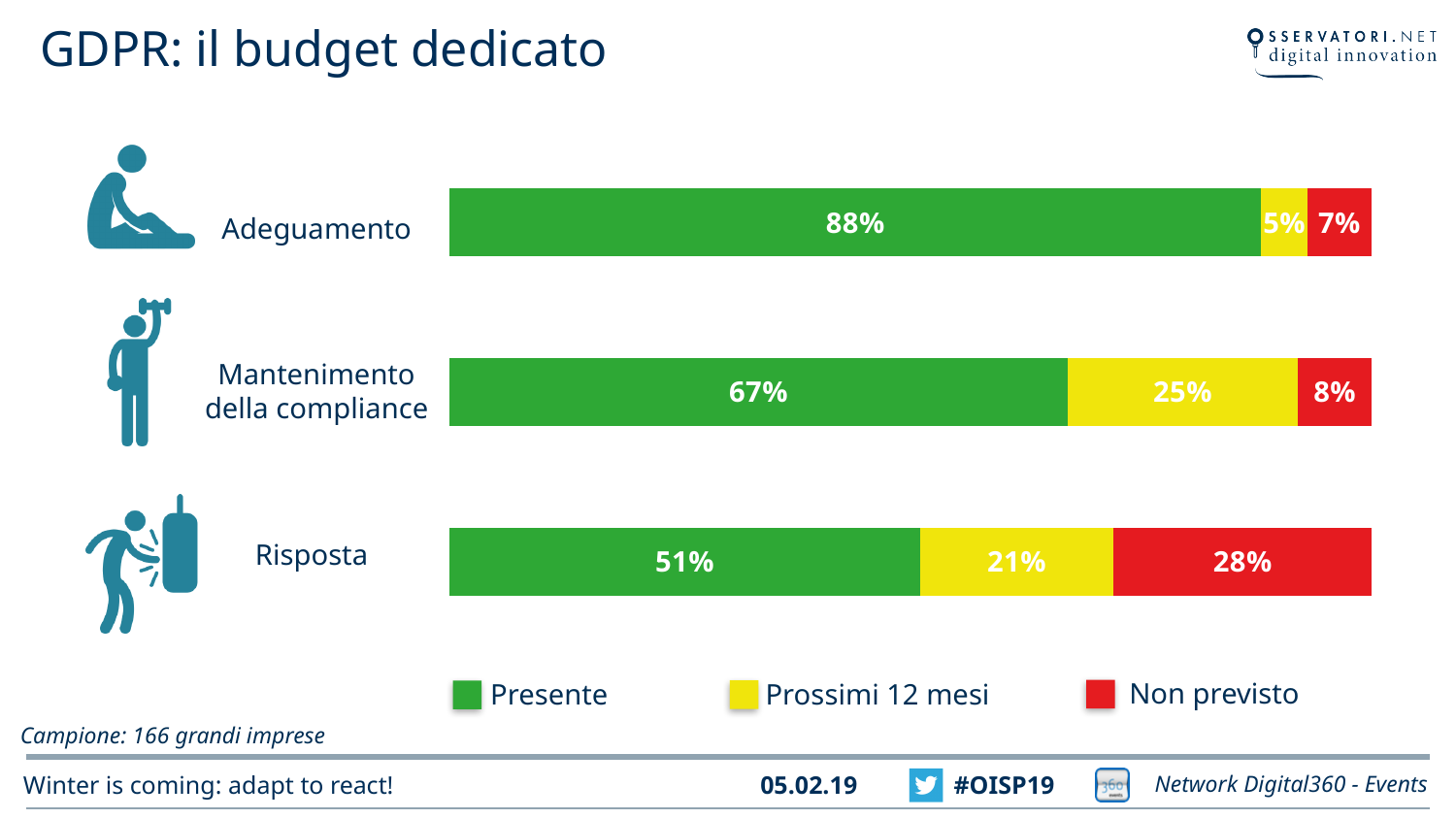
Which colour represents 'Non previsto' in the legend? Red What is the 'Prossimi 12 mesi' value for Mantenimento della compliance? 25% What kind of chart is shown on the slide? Stacked bar chart What is the difference between the 'Presente' values for Adeguamento and Risposta? 37% How many series does the legend list? 3 What is the 'Non previsto' value for Risposta? 28% Which category has the lowest 'Non previsto' value? Adeguamento What is the total of the stacked bar for Risposta? 100% Which is larger: the 'Prossimi 12 mesi' value for Mantenimento della compliance or for Risposta? Mantenimento della compliance Which category has the highest 'Presente' value? Adeguamento What is the 'Presente' value for Adeguamento? 88% How many categories are shown in the chart? 3